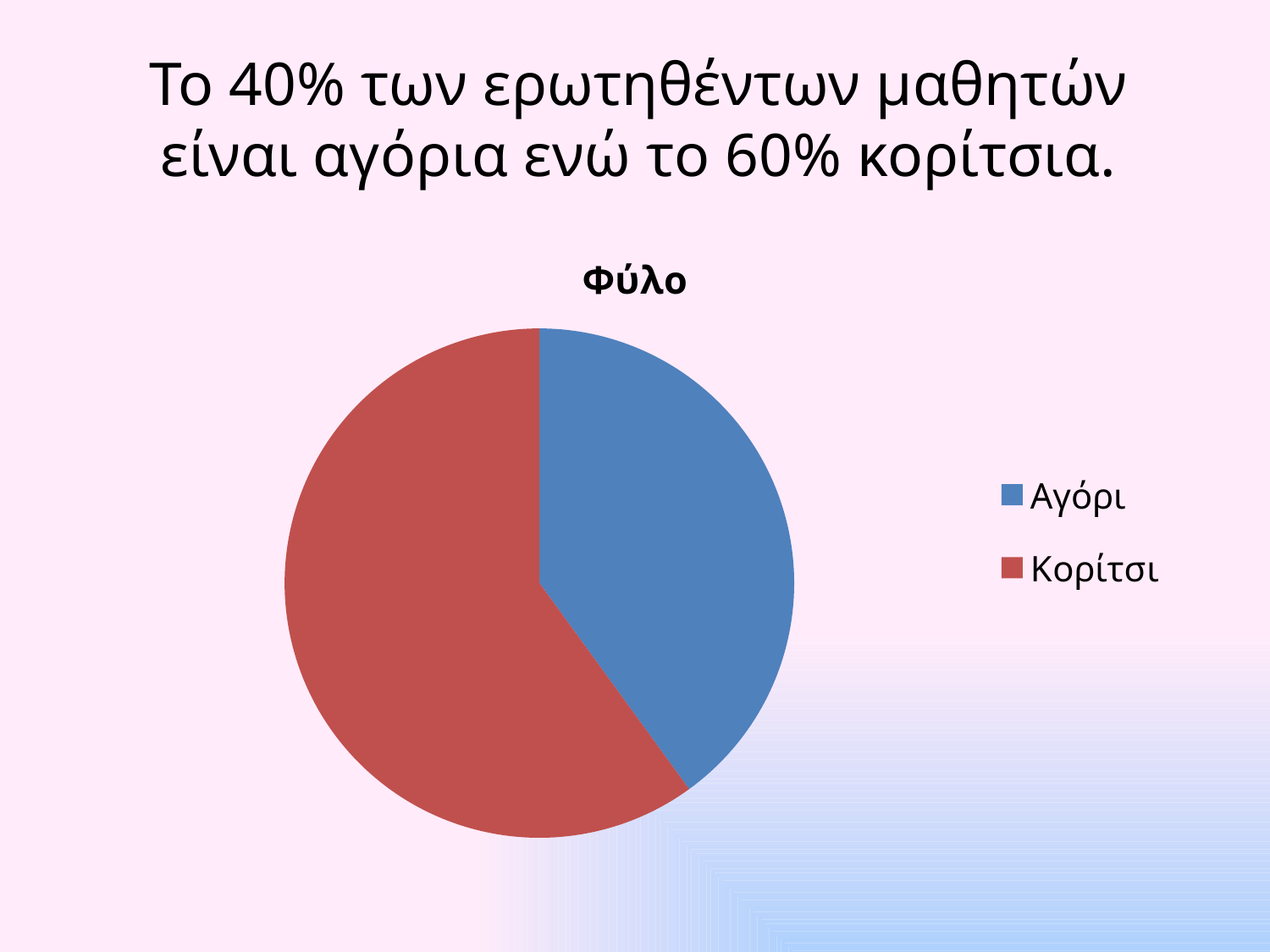
What share of the pie does Αγόρι represent? 40% What is the title of the chart? Φύλο What share of the pie does Κορίτσι represent? 60% What is the difference in percentage points between the Κορίτσι and Αγόρι shares? 20% Which category has the largest share of the pie? Κορίτσι What colour is the Κορίτσι slice? red Which category has the smallest share of the pie? Αγόρι What kind of chart is shown on the slide? pie chart How many slices does the pie chart have? 2 Is the share for Κορίτσι greater or less than 50%? greater Which slice is larger, Αγόρι or Κορίτσι? Κορίτσι How many entries does the legend list? 2